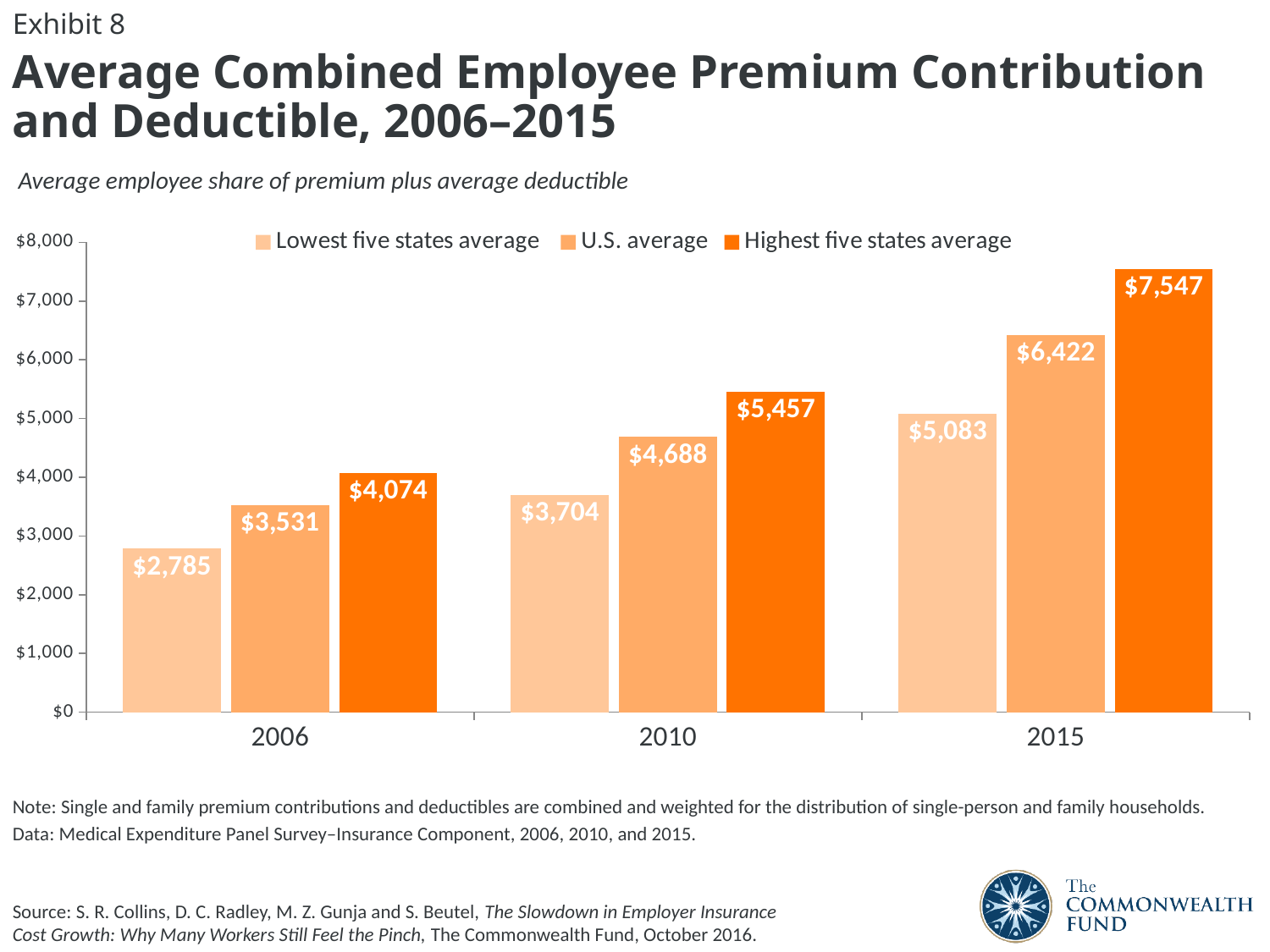
Which year has the highest value for the U.S. average series? 2015 What is the value for the lowest five states average in 2006? $2,785 By how much did the U.S. average increase from 2006 to 2015? $2,891 What is the difference between the highest five states average and the lowest five states average in 2015? $2,464 Do the values for the highest five states average rise or fall from 2006 to 2015? Rise How many years are shown on the x axis? 3 How many series does the legend list? 3 What is the value for the highest five states average in 2015? $7,547 Which series has the lowest value in 2010? Lowest five states average What kind of chart is shown on the slide? Bar chart What is the U.S. average combined employee premium contribution and deductible in 2010? $4,688 Which is larger: the lowest five states average in 2015 or the highest five states average in 2006? Lowest five states average in 2015